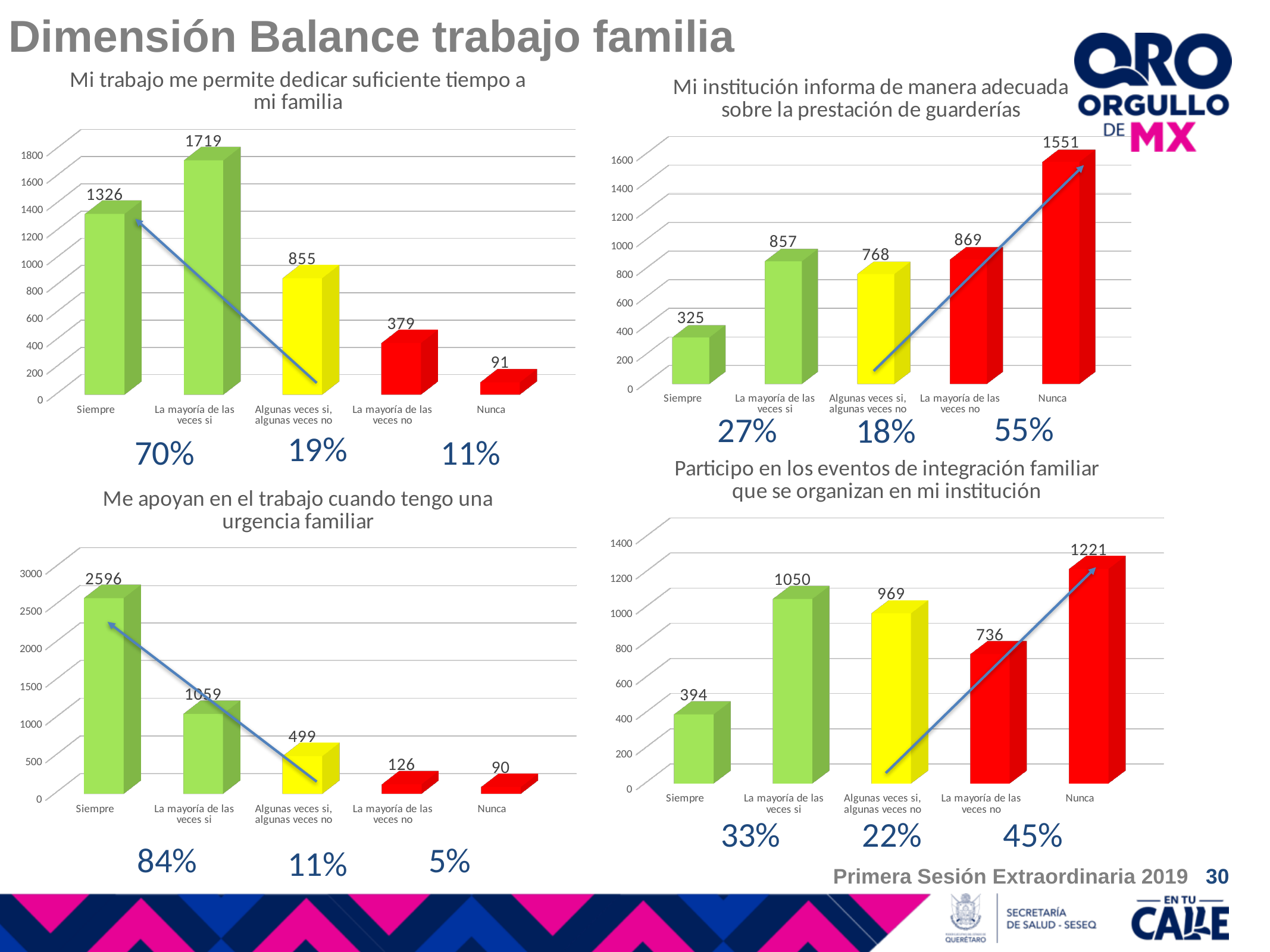
In the chart 'Me apoyan en el trabajo cuando tengo una urgencia familiar', how many categories are shown on the x axis? 5 In the chart 'Me apoyan en el trabajo cuando tengo una urgencia familiar', which is larger: 'La mayoría de las veces no' or 'Nunca'? La mayoría de las veces no In the chart 'Mi trabajo me permite dedicar suficiente tiempo a mi familia', which category has the lowest value? Nunca What kind of chart is 'Participo en los eventos de integración familiar que se organizan en mi institución'? Bar chart In the chart 'Mi institución informa de manera adecuada sobre la prestación de guarderías', what is the value for 'Siempre'? 325 In the chart 'Mi institución informa de manera adecuada sobre la prestación de guarderías', which category has the highest value? Nunca In the chart 'Participo en los eventos de integración familiar que se organizan en mi institución', what is the difference between 'Nunca' and 'Siempre'? 827 In the chart 'Mi trabajo me permite dedicar suficiente tiempo a mi familia', what is the value for 'La mayoría de las veces si'? 1719 In the chart 'Participo en los eventos de integración familiar que se organizan en mi institución', what is the value for 'Algunas veces si, algunas veces no'? 969 In the chart 'Mi institución informa de manera adecuada sobre la prestación de guarderías', what is the difference between 'La mayoría de las veces no' and 'La mayoría de las veces si'? 12 In the chart 'Mi trabajo me permite dedicar suficiente tiempo a mi familia', what colour are the bars for 'La mayoría de las veces no' and 'Nunca'? Red In the chart 'Me apoyan en el trabajo cuando tengo una urgencia familiar', what is the value for 'Siempre'? 2596